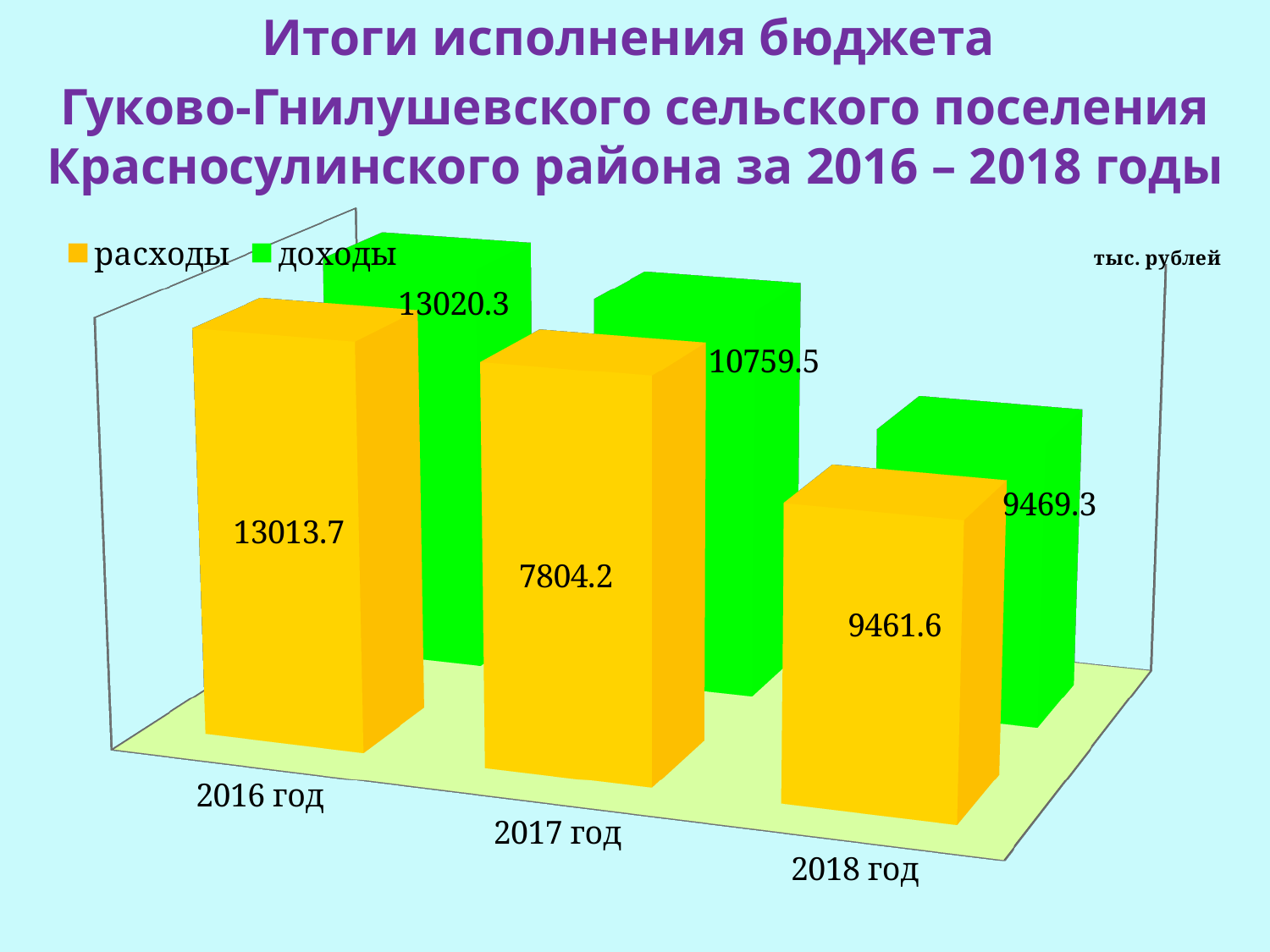
Do доходы rise or fall from 2016 год to 2018 год? fall How many series does the legend list? 2 What kind of chart is shown on the slide? bar chart What is the difference between доходы and расходы in 2017 год? 2955.3 What is the value for доходы in 2017 год? 10759.5 What is the value for расходы in 2016 год? 13013.7 In which year are доходы the highest? 2016 год In 2017 год, which is larger: доходы or расходы? доходы By how much did доходы fall from 2016 год to 2018 год? 3551.0 What is the value for расходы in 2018 год? 9461.6 How many years are shown on the chart? 3